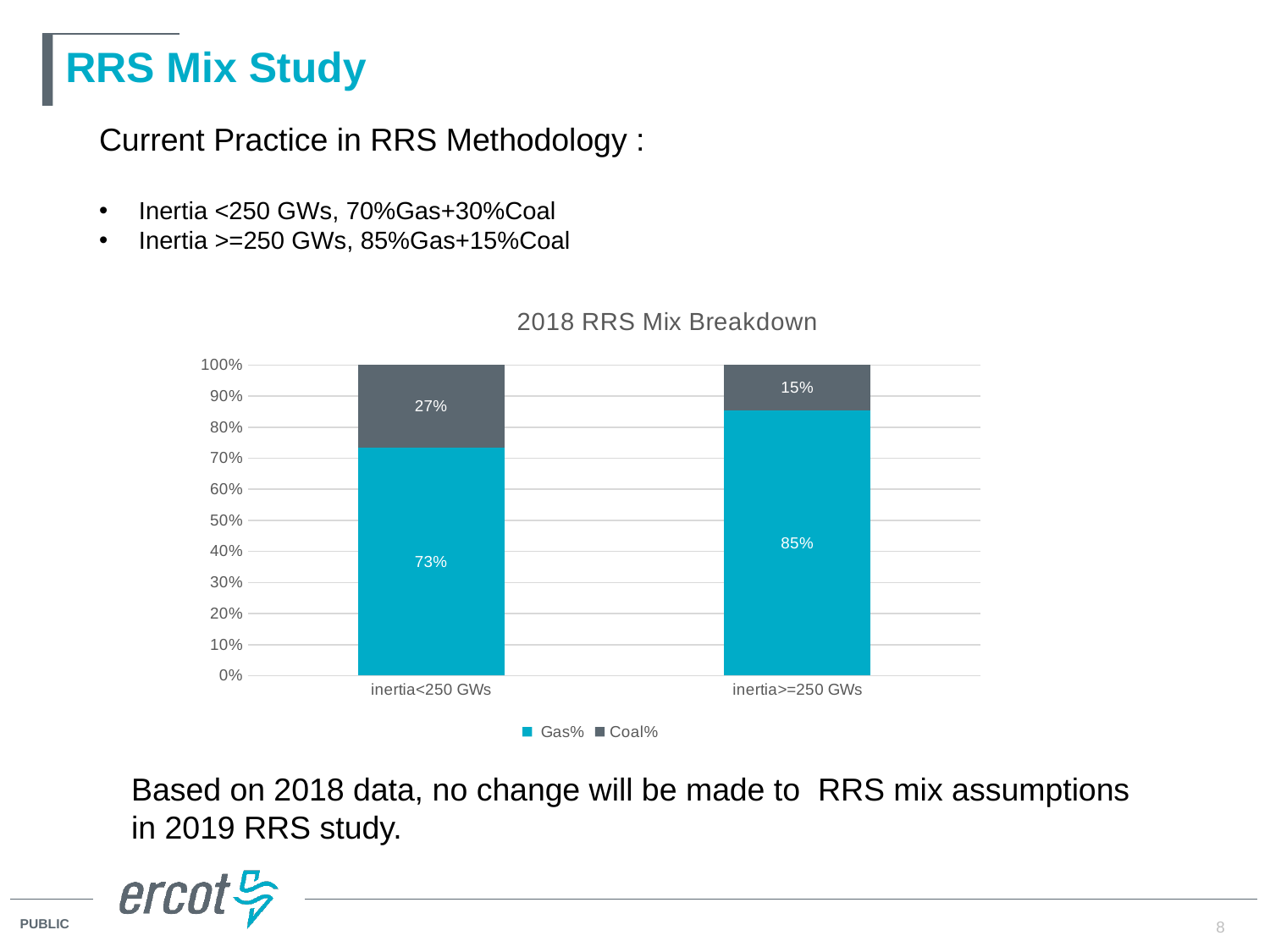
What is the title of the chart? 2018 RRS Mix Breakdown How many series does the legend list? 2 Which category has the higher Gas% value? inertia>=250 GWs Which category has the lower Coal% value? inertia>=250 GWs What kind of chart is shown on the slide? stacked bar chart Is the Coal% value for inertia<250 GWs larger or smaller than the Coal% value for inertia>=250 GWs? larger What is the Coal% value for inertia<250 GWs? 27% What is the Gas% value for inertia<250 GWs? 73% What is the Coal% value for inertia>=250 GWs? 15% What is the difference between the Gas% values for inertia>=250 GWs and inertia<250 GWs? 12% What is the Gas% value for inertia>=250 GWs? 85% How many categories are shown on the x axis? 2